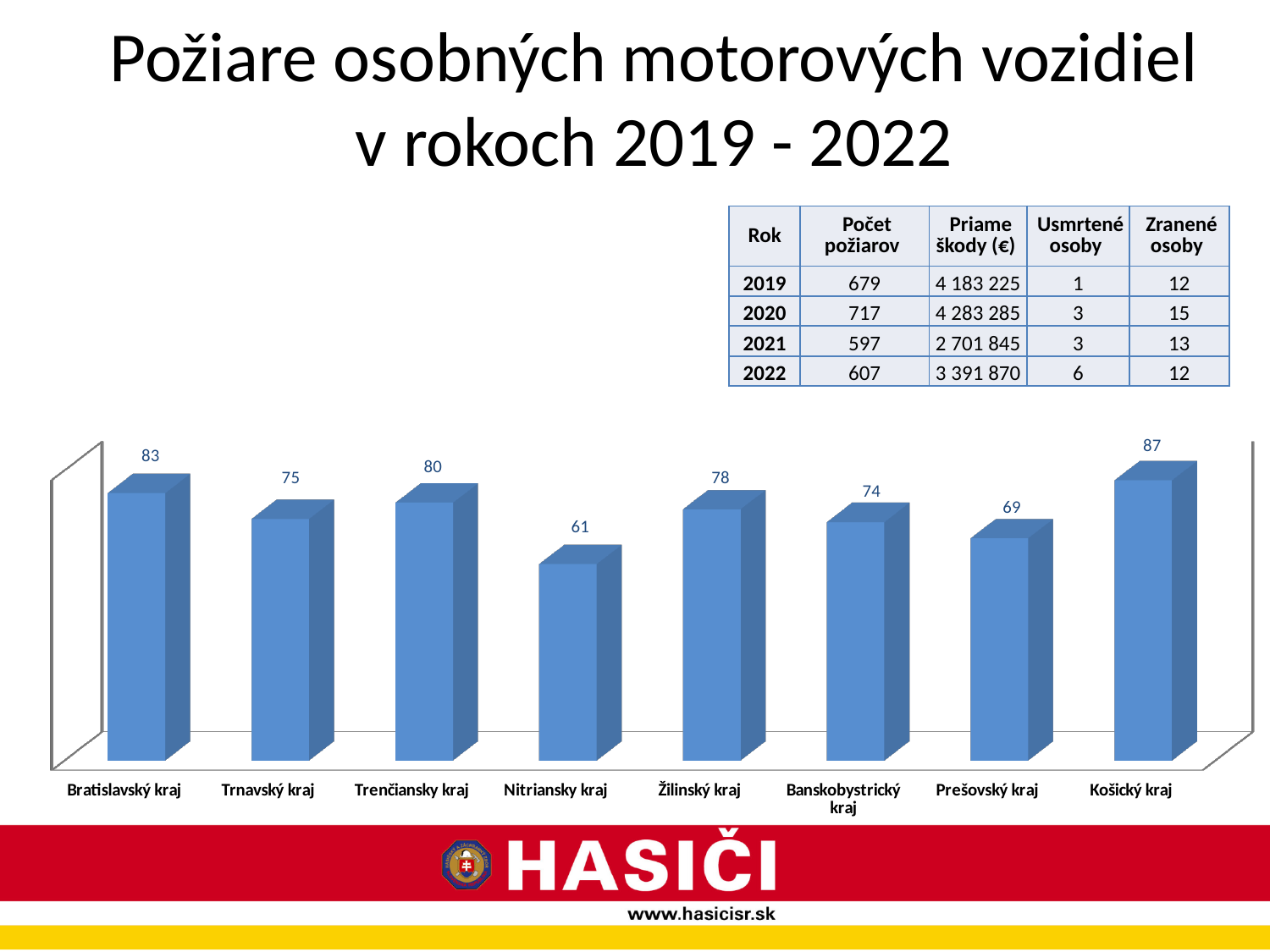
What colour are the bars in the chart? blue What is the value for Žilinský kraj? 78 What is the value for Bratislavský kraj? 83 What is the difference between the values for Košický kraj and Nitriansky kraj? 26 What is the value for Nitriansky kraj? 61 What kind of chart is shown on the slide? bar chart Which is larger, the value for Žilinský kraj or the value for Banskobystrický kraj? Žilinský kraj How many regions are shown in the chart? 8 Which region has the highest value? Košický kraj What is the value for Prešovský kraj? 69 Which region has the lowest value? Nitriansky kraj What is the difference between the values for Trenčiansky kraj and Trnavský kraj? 5